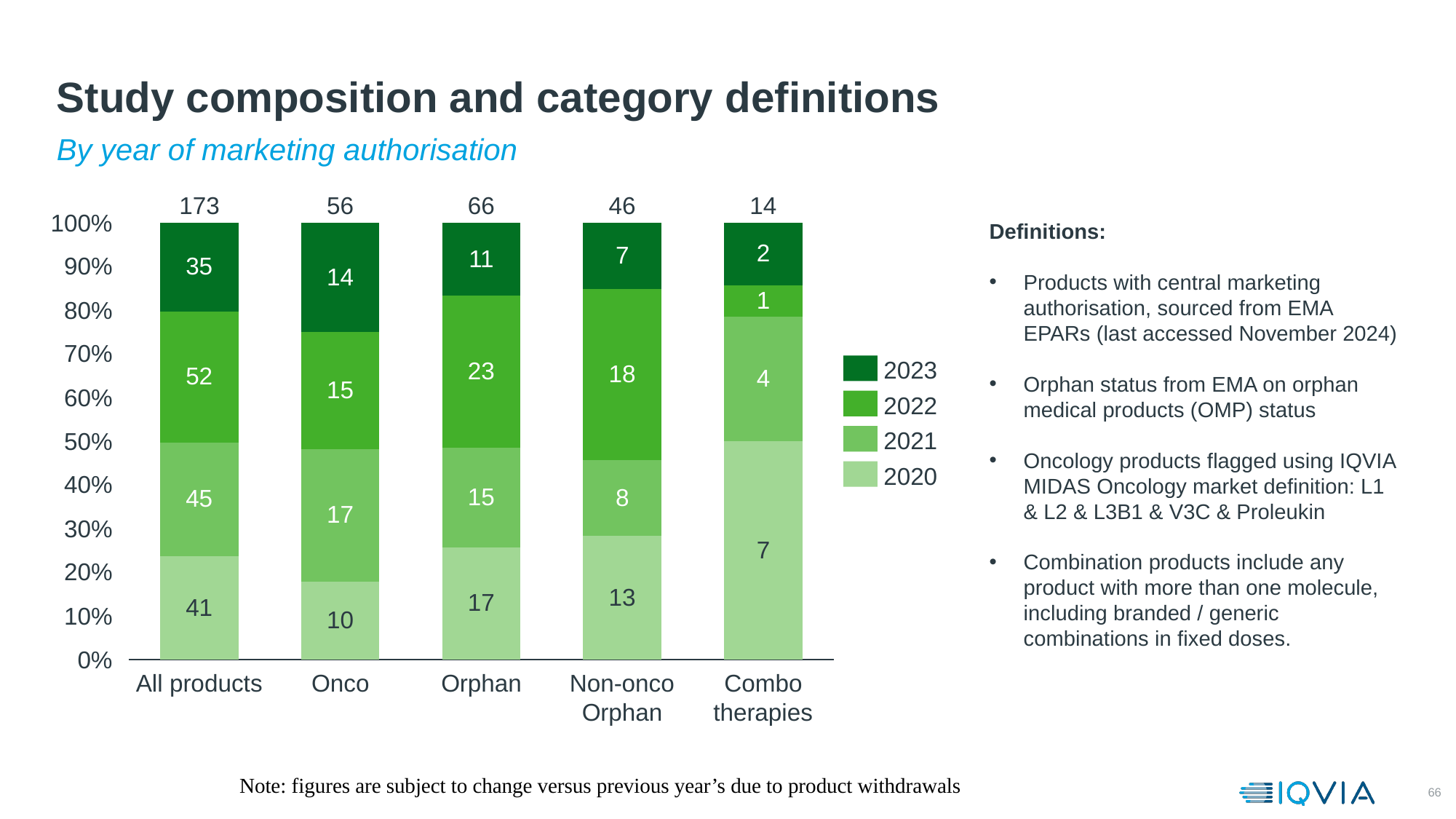
What is the difference between the 2021 value for Onco and the 2021 value for Non-onco Orphan? 9 What kind of chart is shown on the slide? Stacked bar chart What is the total printed above the Non-onco Orphan bar? 46 How many series does the legend list? 4 Which category has the highest total printed above its bar? All products Which category has the lowest total printed above its bar? Combo therapies What is the subtitle of the chart? By year of marketing authorisation Which is larger, the 2023 value for Onco or the 2023 value for Orphan? Onco What is the 2022 value for Orphan? 23 What is the 2020 value for All products? 41 How many categories are shown on the x axis of the chart? 5 What is the 2023 value for Combo therapies? 2